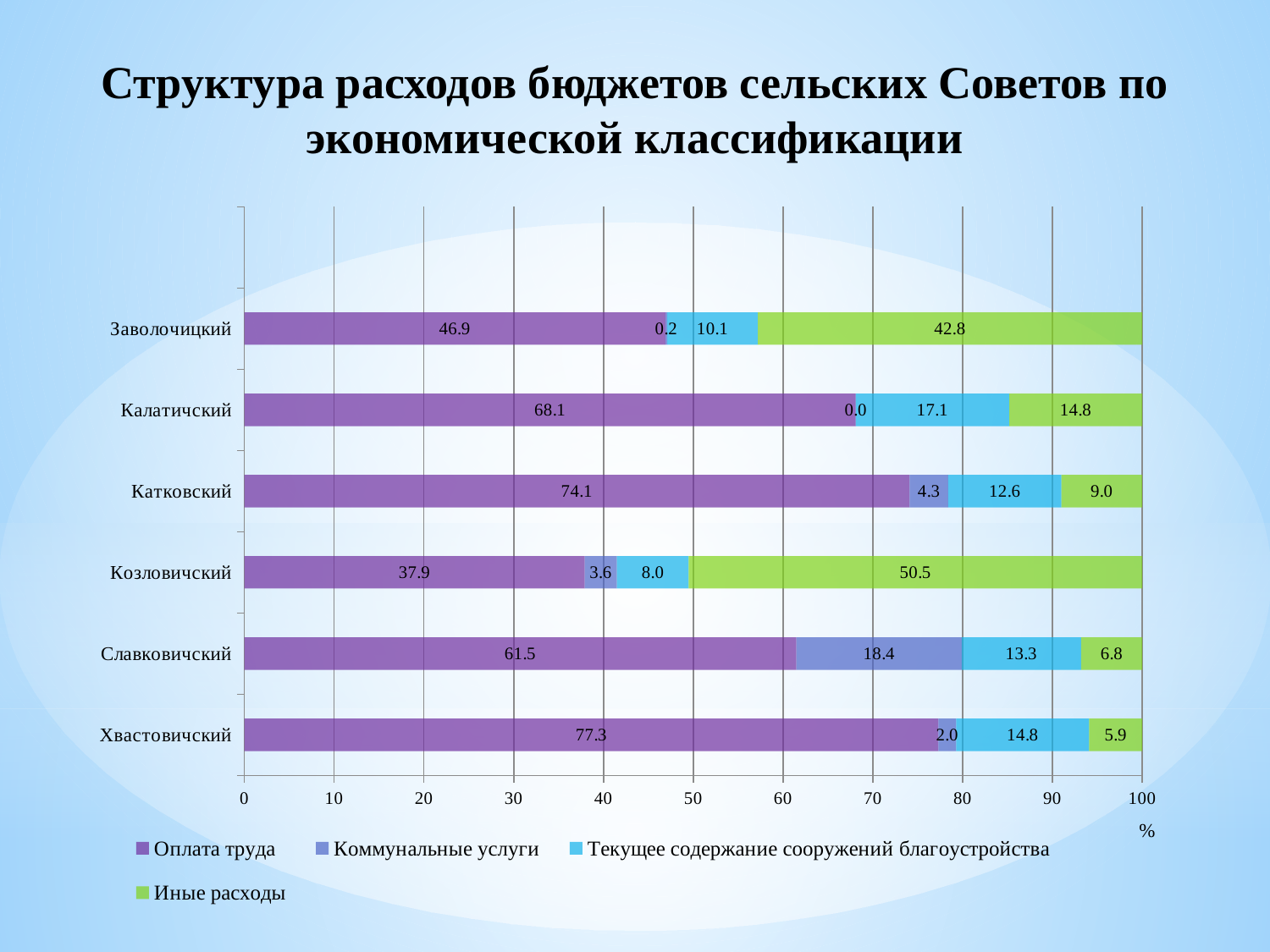
Which has a larger value for Иные расходы, Заволочицкий or Калатичский? Заволочицкий What is the total of the stacked bar for Катковский? 100.0 How many categories are shown on the chart? 6 Which category has the highest value for Коммунальные услуги? Славковичский What is the value of Иные расходы for Козловичский? 50.5 What is the value of Оплата труда for Хвастовичский? 77.3 What kind of chart is shown on the slide? Stacked bar chart How many series does the legend list? 4 Which category has the lowest value for Оплата труда? Козловичский What is the value of Текущее содержание сооружений благоустройства for Калатичский? 17.1 Which category has the highest value for Оплата труда? Хвастовичский What is the difference between the Оплата труда values for Хвастовичский and Козловичский? 39.4